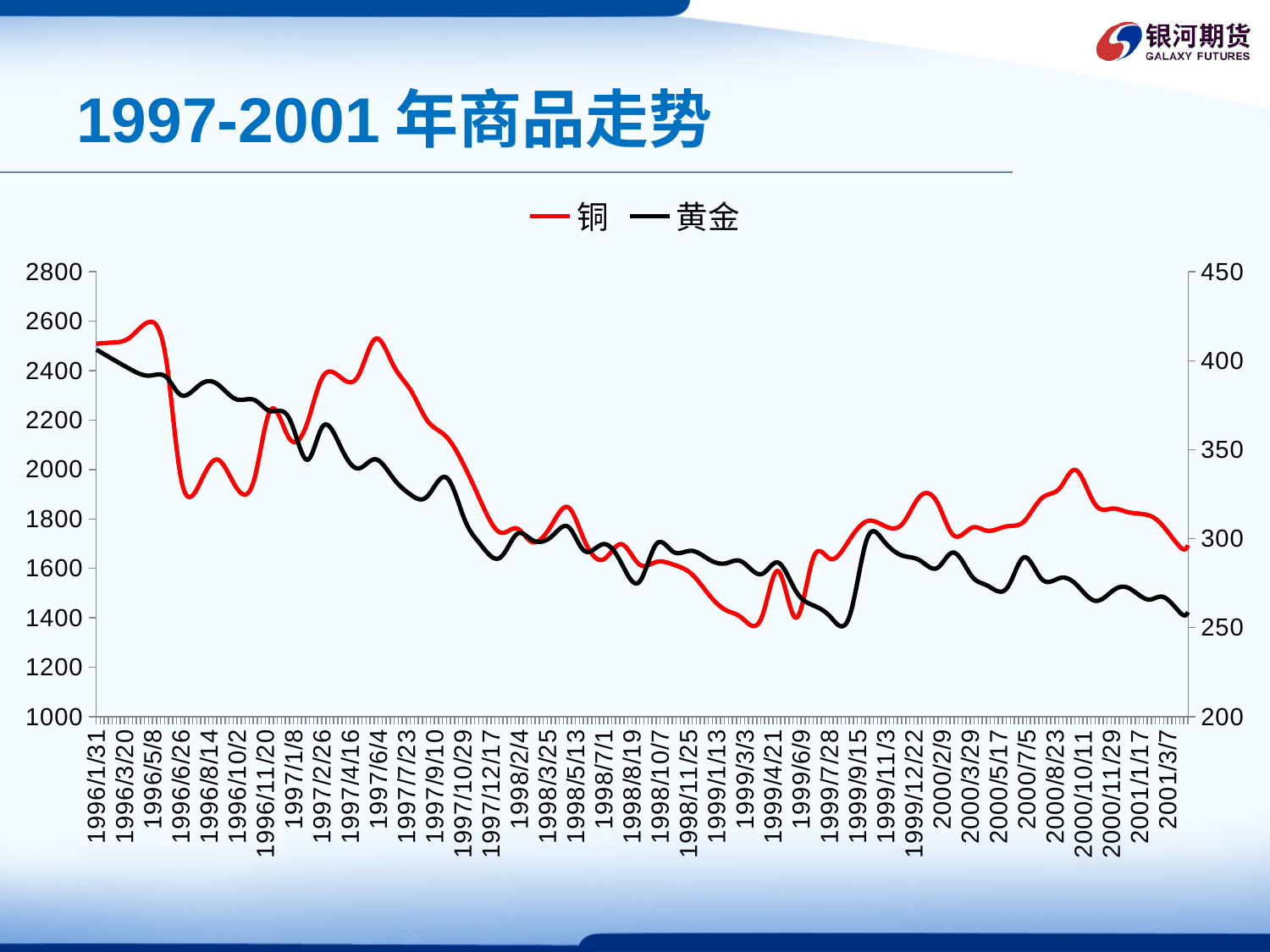
Overall, does the 铜 line rise or fall from 1996/1/31 to the end of the x axis? fall What kind of chart is shown on the slide? line chart Overall, does the 黄金 line rise or fall from 1996/1/31 to the end of the x axis? fall On the right axis, is the value for 黄金 at 1996/1/31 greater or less than 400? greater On the left axis, is the value for 铜 at 2000/10/11 greater or less than 1800? greater What colour is the line for 铜? red On the left axis, is the value for 铜 at 1999/3/3 greater or less than 1600? less What is the title of the chart on the slide? 1997-2001 年商品走势 How many series does the legend list? 2